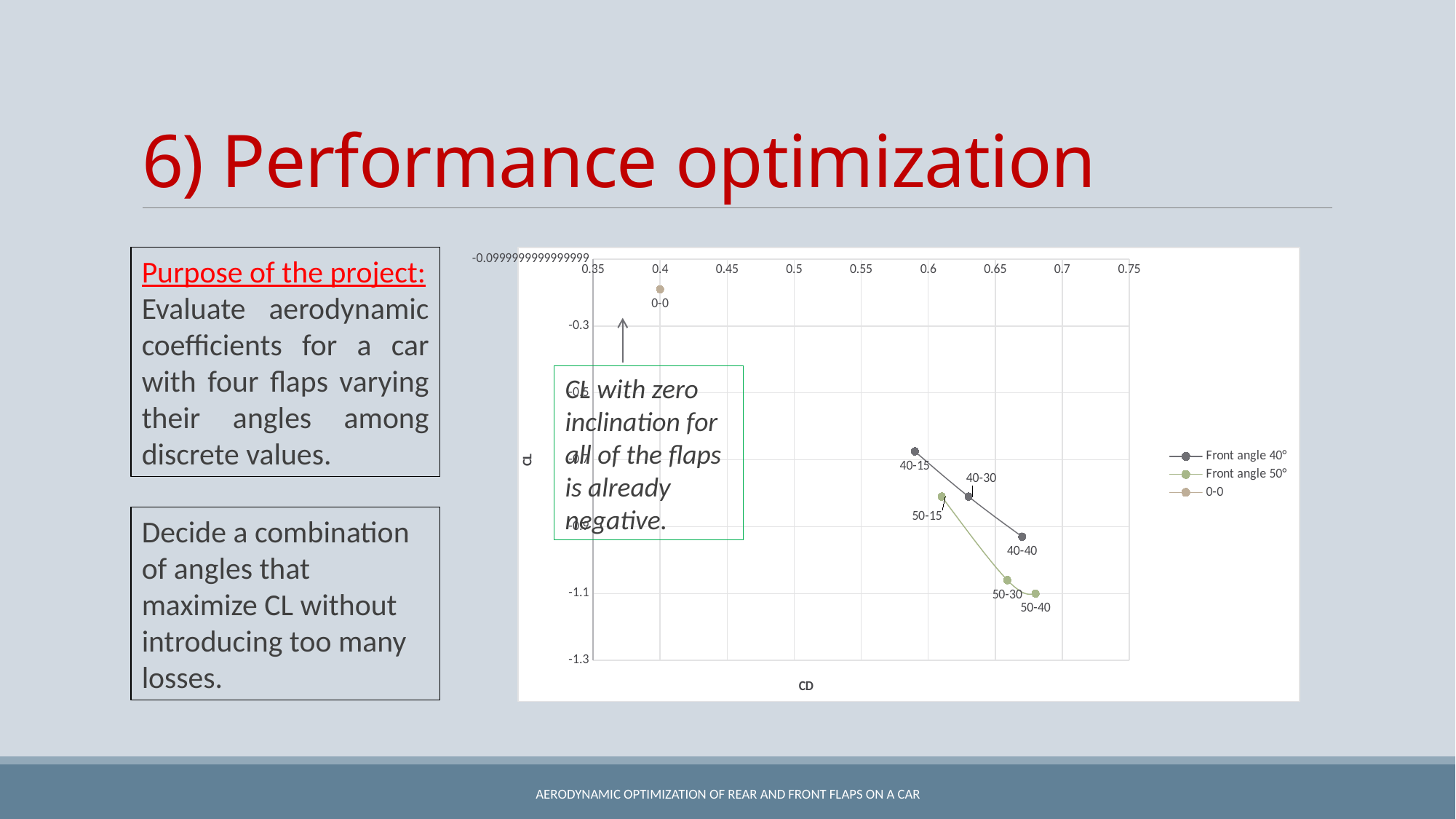
Is the CD value for the 50-40 point greater or less than 0.65? greater How many labelled data points are plotted in total on the chart? 7 Is the CD value for the 40-15 point greater or less than 0.55? greater Which point has the lower CL value, 40-40 or 50-40? 50-40 Is the CL value for the 0-0 point greater or less than -0.3? greater What kind of chart is shown on the slide? scatter chart with lines What is the label of the vertical axis? CL What is the label of the horizontal axis? CD Along the Front angle 40° series, does CL rise or fall as CD increases? fall How many data points are plotted in the Front angle 50° series? 3 How many series does the legend list? 3